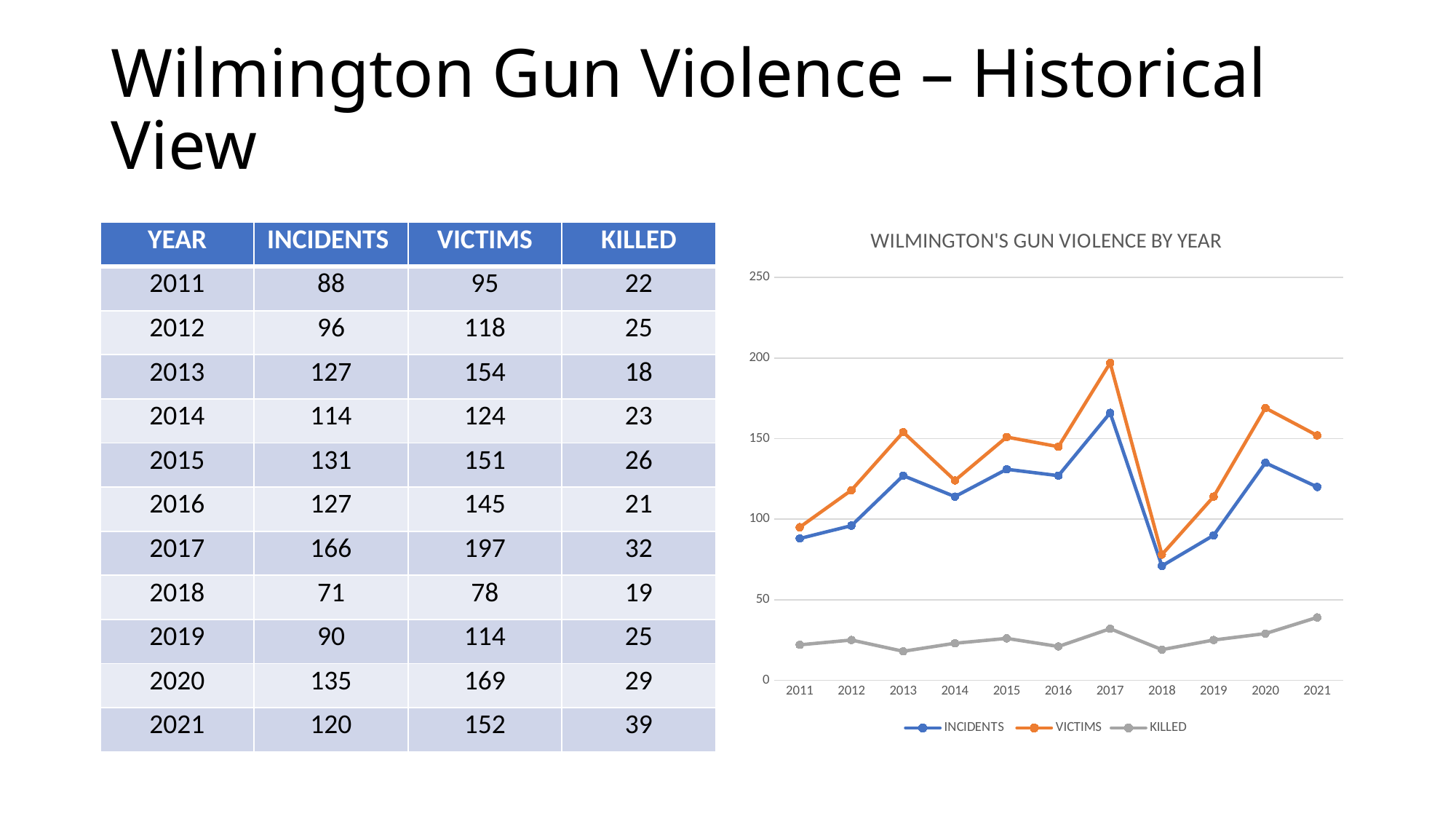
Which year has the highest number of VICTIMS? 2017 What is the title of the chart? WILMINGTON'S GUN VIOLENCE BY YEAR What is the difference between VICTIMS and INCIDENTS in 2021? 32 Which year has the lowest number of INCIDENTS? 2018 What is the number of INCIDENTS in 2020? 135 Which is larger, INCIDENTS in 2013 or INCIDENTS in 2019? INCIDENTS in 2013 Is the value for VICTIMS in 2018 greater or less than 100? less Does the KILLED series rise or fall from 2018 to 2021? rise How many years are plotted along the x axis of the chart? 11 What is the number of VICTIMS in 2017? 197 How many series does the chart's legend list? 3 What kind of chart is shown on the slide? line chart